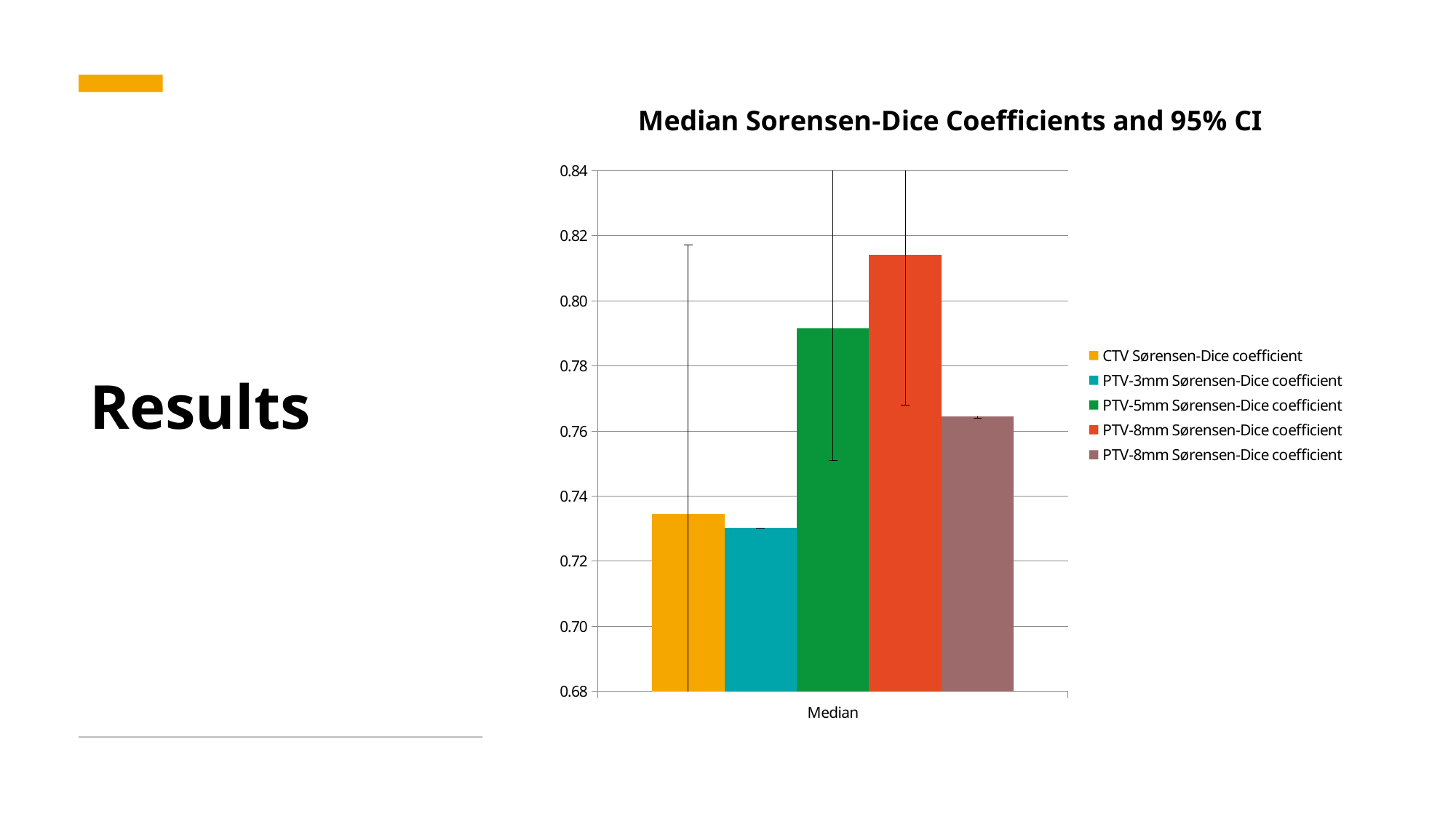
Is the value for CTV Sørensen-Dice coefficient greater or less than 0.74? less What is the label of the single category on the x axis? Median Which series has the highest bar? PTV-8mm Sørensen-Dice coefficient (red bar) How many categories are shown on the x axis? 1 How many series does the legend list? 5 Which series has the lowest bar? PTV-3mm Sørensen-Dice coefficient What is the title of the chart? Median Sorensen-Dice Coefficients and 95% CI Which is larger, the PTV-5mm Sørensen-Dice coefficient or the CTV Sørensen-Dice coefficient? PTV-5mm Sørensen-Dice coefficient Is the value for PTV-5mm Sørensen-Dice coefficient greater or less than 0.78? greater Is the value of the brown PTV-8mm Sørensen-Dice coefficient bar greater or less than 0.78? less What kind of chart is shown on the slide? bar chart